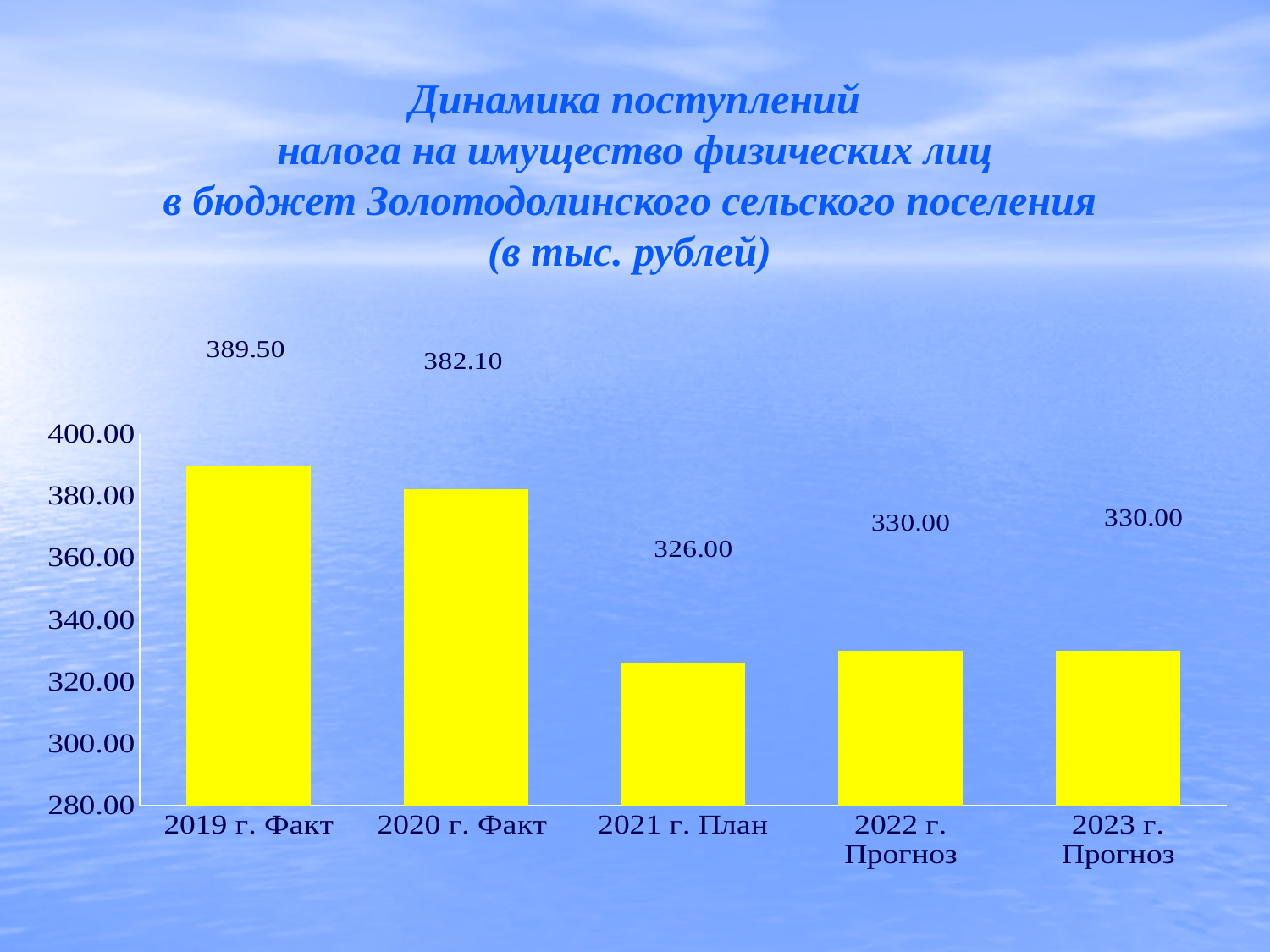
Which category has the highest value? 2019 г. Факт What is the value for 2021 г. План? 326.00 What colour are the bars in the chart? yellow How many categories are shown on the x axis? 5 What is the difference between the values for 2019 г. Факт and 2020 г. Факт? 7.40 What is the value for 2023 г. Прогноз? 330.00 What kind of chart is shown on the slide? bar chart What is the difference between the values for 2022 г. Прогноз and 2021 г. План? 4.00 What is the value for 2019 г. Факт? 389.50 Which category has the lowest value? 2021 г. План Which is larger, the value for 2020 г. Факт or the value for 2022 г. Прогноз? 2020 г. Факт Is the value for 2021 г. План greater or less than 340.00? less